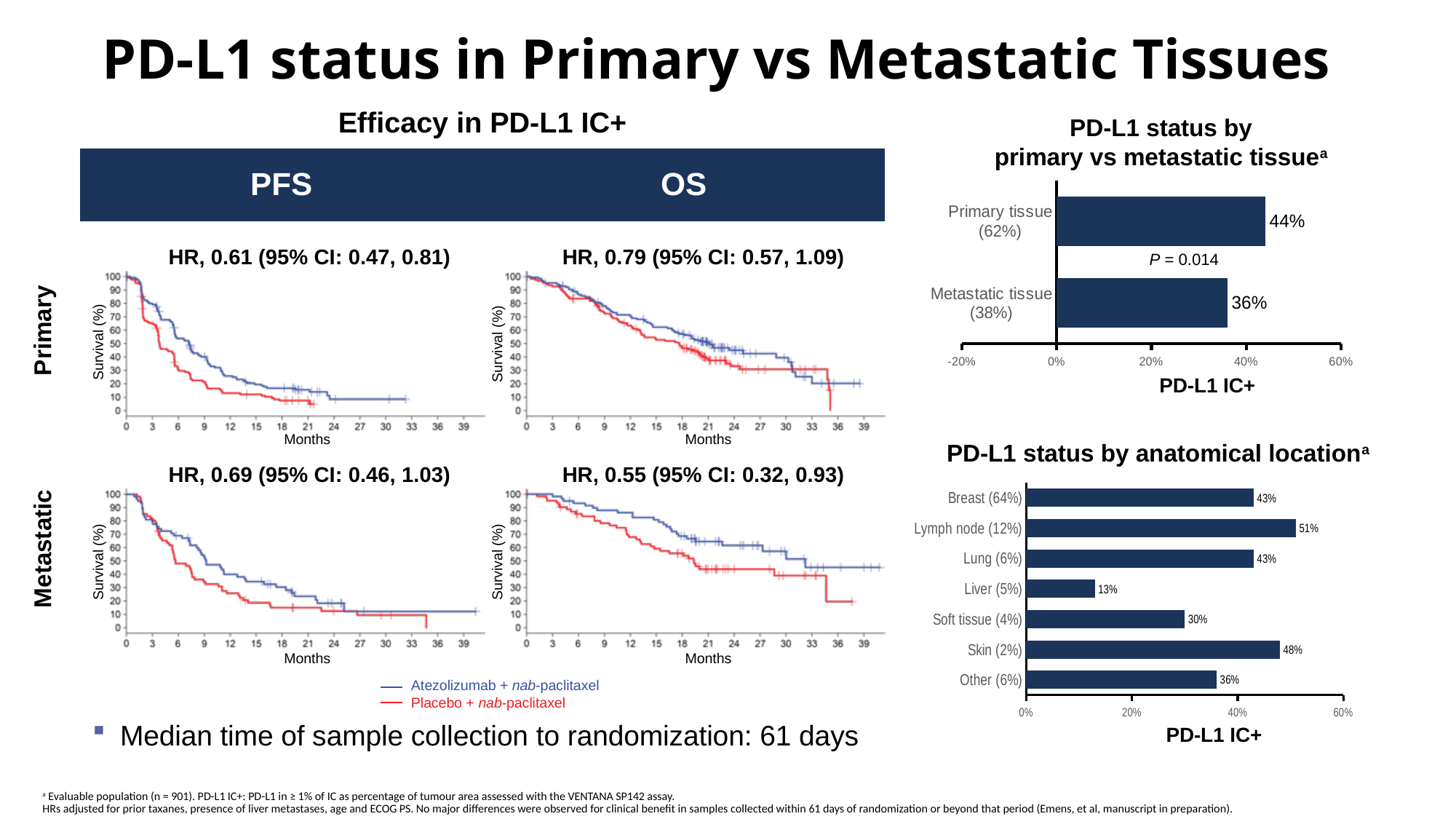
In the 'PD-L1 status by anatomical location' chart, what is the difference between the Lymph node (12%) and Liver (5%) values? 38% In the 'PD-L1 status by primary vs metastatic tissue' chart, what is the PD-L1 IC+ value for primary tissue? 44% In the 'PD-L1 status by anatomical location' chart, which location has the lowest PD-L1 IC+ value? Liver (5%) In the 'PD-L1 status by anatomical location' chart, what is the value for Skin (2%)? 48% In the 'PD-L1 status by primary vs metastatic tissue' chart, what is the difference between the primary tissue and metastatic tissue values? 8% In the 'PD-L1 status by anatomical location' chart, how many anatomical locations are plotted? 7 In the 'PD-L1 status by anatomical location' chart, which is larger, the value for Skin (2%) or the value for Other (6%)? Skin (2%) In the 'PD-L1 status by anatomical location' chart, what is the value for Soft tissue (4%)? 30% In the 'PD-L1 status by anatomical location' chart, which location has the highest PD-L1 IC+ value? Lymph node (12%) In the 'PD-L1 status by primary vs metastatic tissue' chart, what P value is shown? P = 0.014 What type of chart is the 'PD-L1 status by anatomical location' chart? Bar chart In the 'PD-L1 status by primary vs metastatic tissue' chart, what is the PD-L1 IC+ value for metastatic tissue? 36%